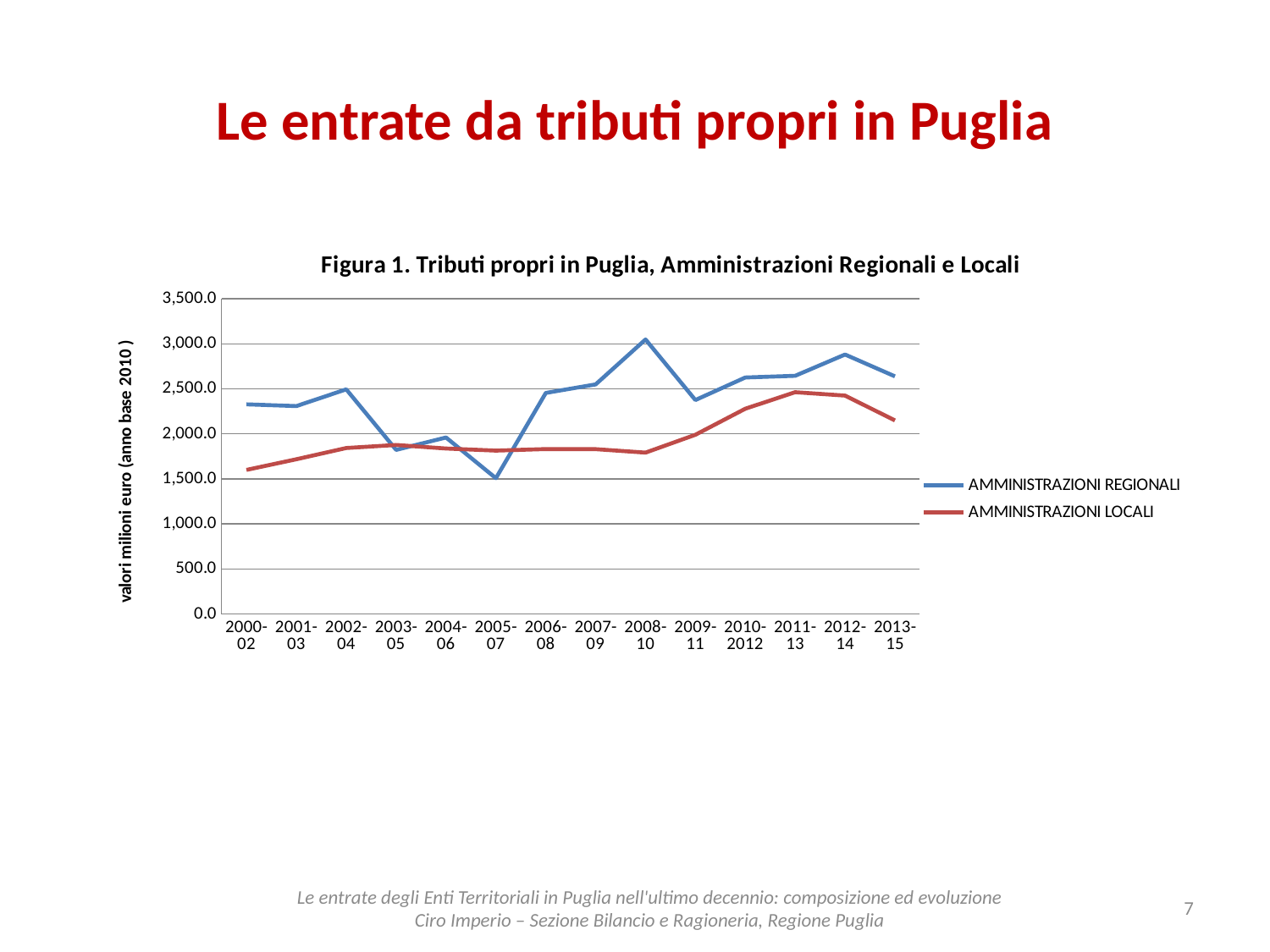
In 2005-07, which series has the larger value, AMMINISTRAZIONI REGIONALI or AMMINISTRAZIONI LOCALI? AMMINISTRAZIONI LOCALI In which period does the AMMINISTRAZIONI REGIONALI series reach its lowest value? 2005-07 How many series does the legend list? 2 Does the AMMINISTRAZIONI LOCALI series rise or fall from 2008-10 to 2011-13? rise How many periods are plotted along the x axis? 14 Is the value for AMMINISTRAZIONI LOCALI in 2000-02 greater or less than 2,000.0? less In which period does the AMMINISTRAZIONI LOCALI series have its lowest value? 2000-02 Is the value for AMMINISTRAZIONI REGIONALI in 2005-07 greater or less than 2,000.0? less In 2008-10, which series has the larger value, AMMINISTRAZIONI REGIONALI or AMMINISTRAZIONI LOCALI? AMMINISTRAZIONI REGIONALI In which period does the AMMINISTRAZIONI REGIONALI series reach its highest value? 2008-10 What kind of chart is shown in Figura 1? line chart Is the value for AMMINISTRAZIONI REGIONALI in 2012-14 greater or less than 2,500.0? greater